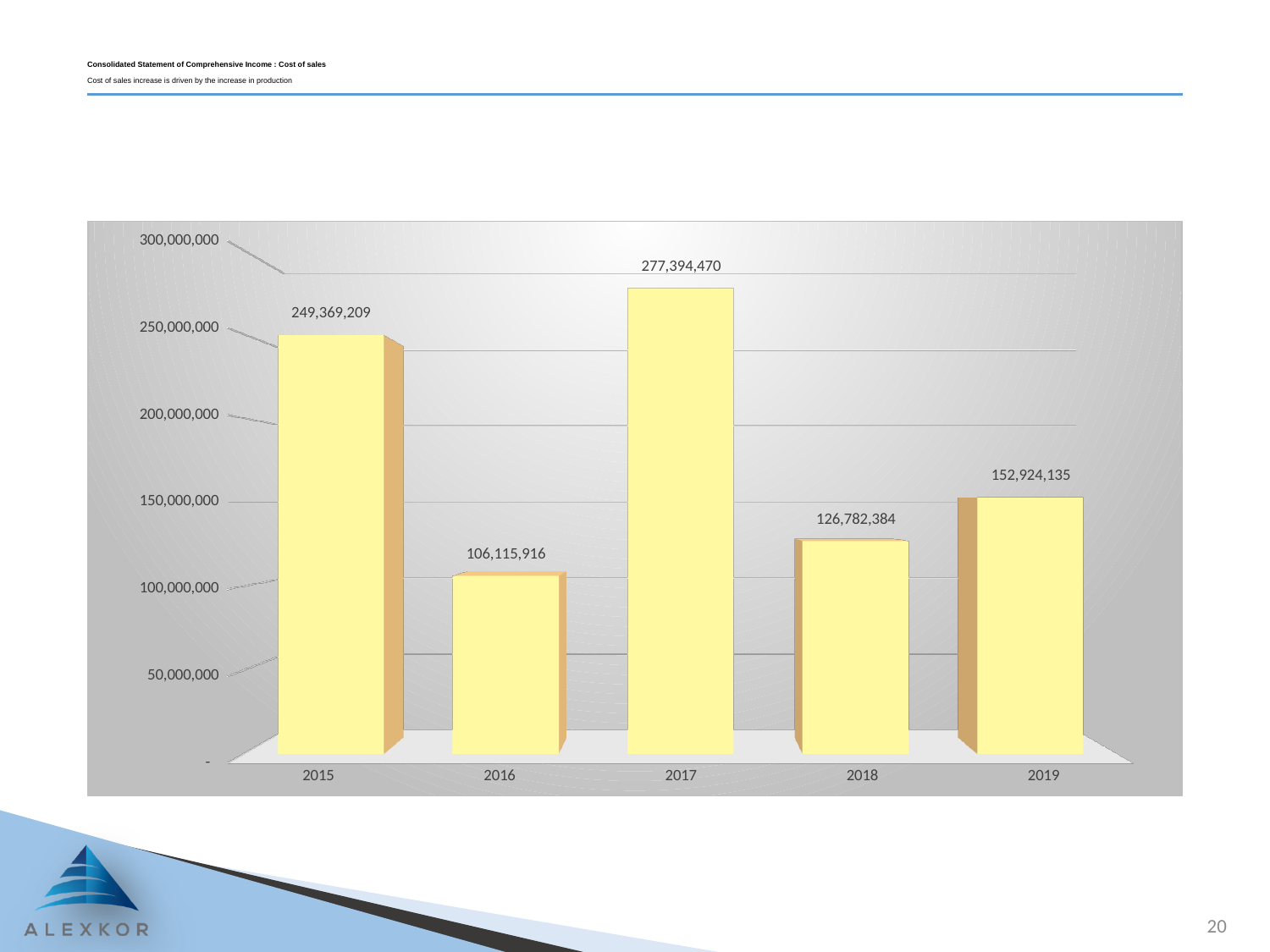
Which is larger, the value for 2018 or the value for 2016? 2018 What kind of chart is shown on the slide? bar chart What is the value shown for 2019? 152,924,135 What is the value shown for 2017? 277,394,470 How many years are shown on the x axis? 5 What is the difference between the values for 2017 and 2015? 28,025,261 Did the value rise or fall from 2017 to 2018? fall What is the difference between the values for 2019 and 2018? 26,141,751 Which year has the highest value? 2017 Which year has the lowest value? 2016 Is the value for 2019 greater or less than 150,000,000? greater What is the value shown for 2015? 249,369,209